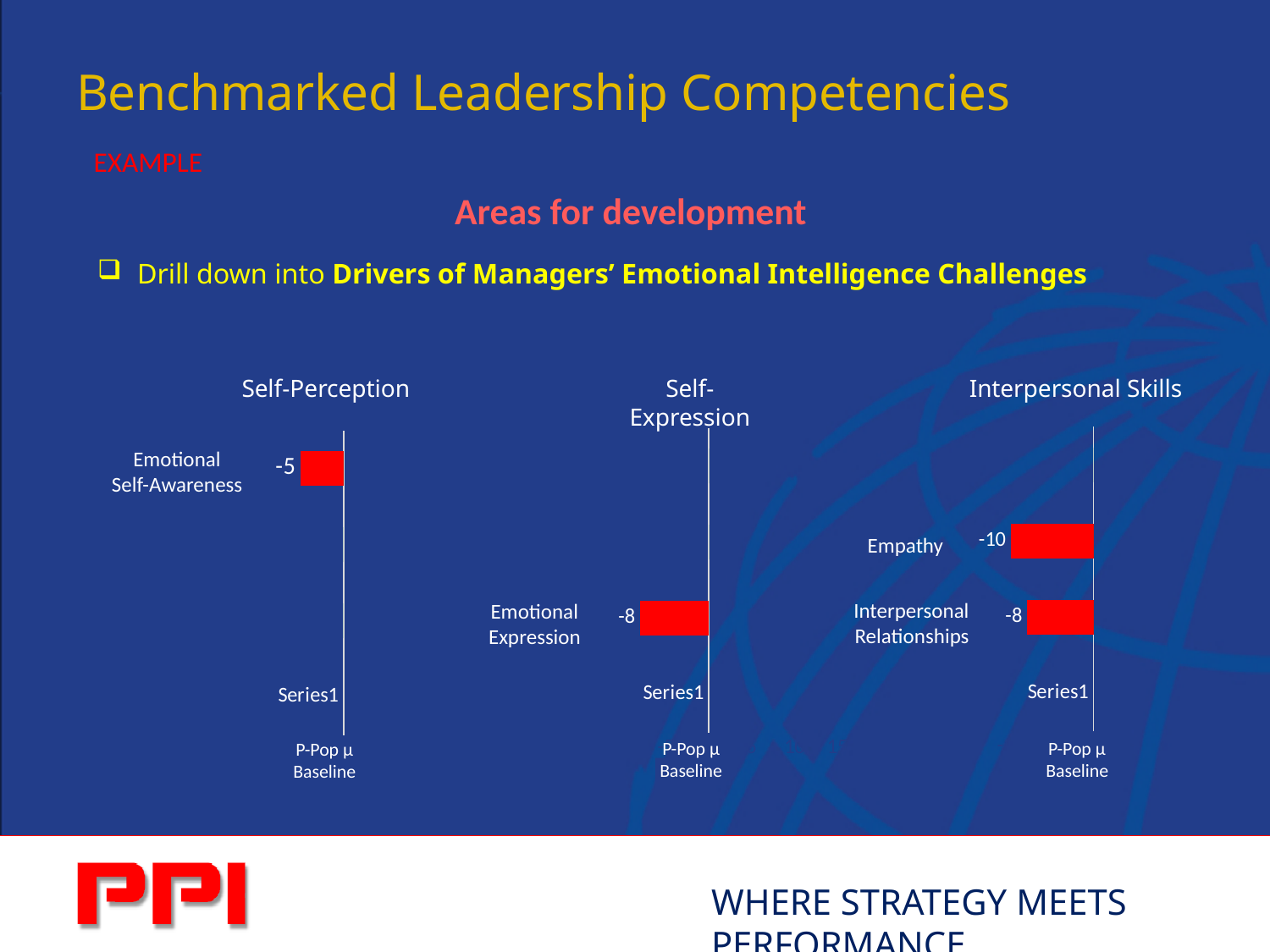
In the Interpersonal Skills chart, what is the value for Interpersonal Relationships? -8 How many categories are plotted in the Self-Perception chart? 1 In the Interpersonal Skills chart, which is larger, the value for Empathy or the value for Interpersonal Relationships? Interpersonal Relationships What kind of chart is the Self-Expression chart? Bar chart In the Self-Expression chart, what is the value for Emotional Expression? -8 In the Interpersonal Skills chart, what is the difference between the values for Empathy and Interpersonal Relationships? 2 In the Self-Perception chart, what is the value for Emotional Self-Awareness? -5 How many charts are shown on the slide? 3 In the Interpersonal Skills chart, which category has the lowest value? Empathy In the Interpersonal Skills chart, what is the value for Empathy? -10 In the Interpersonal Skills chart, which category has the highest value? Interpersonal Relationships How many categories are plotted in the Interpersonal Skills chart? 2